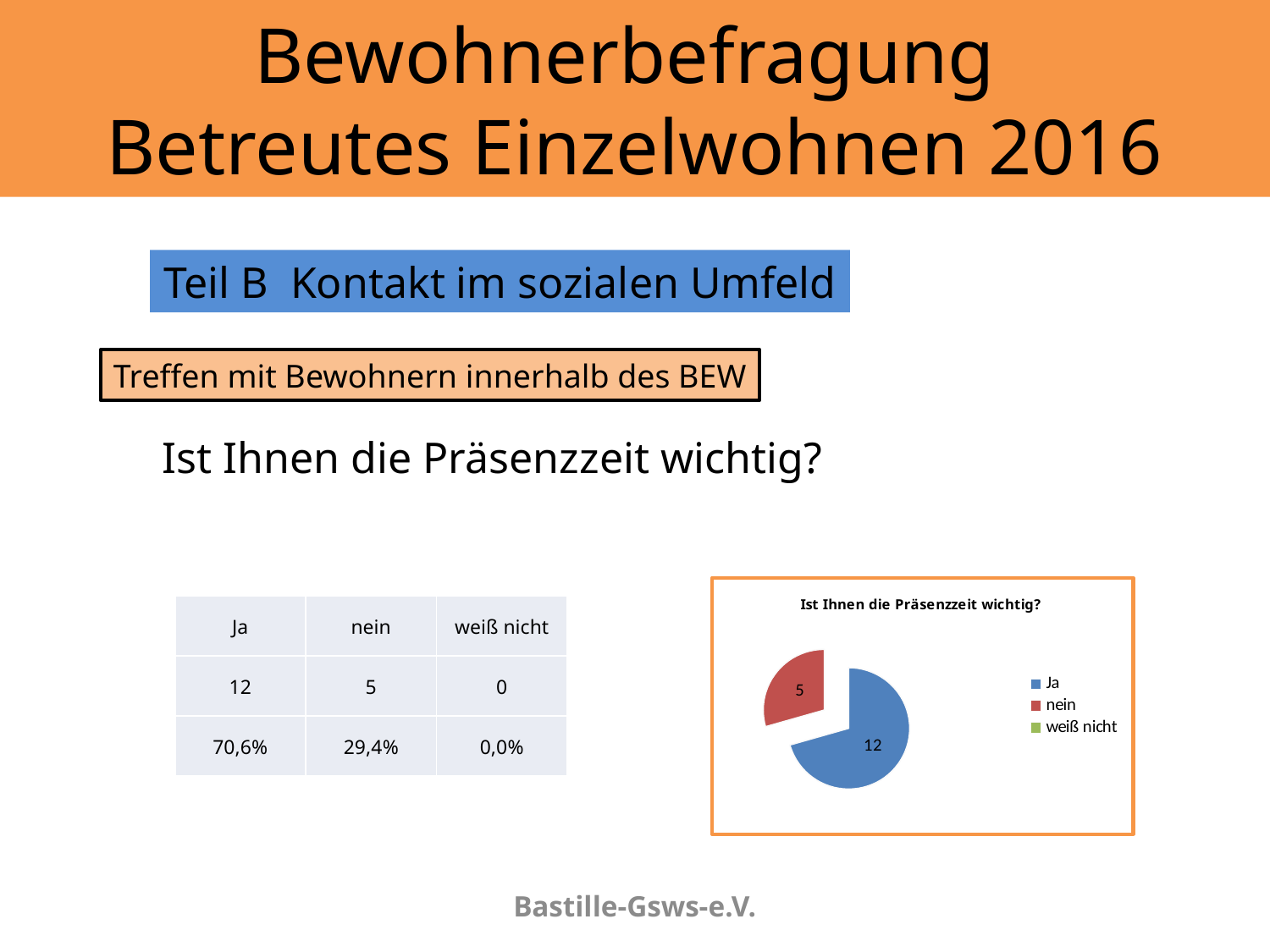
What colour is the "nein" slice in the pie chart? red What is the total of the values shown in the pie chart? 17 What is the value of the "Ja" slice in the pie chart? 12 What is the title of the pie chart? Ist Ihnen die Präsenzzeit wichtig? What share of the pie does the "Ja" slice represent, according to the table on the slide? 70,6% How many entries does the legend of the pie chart list? 3 What is the difference between the "Ja" and "nein" values in the pie chart? 7 What type of chart is shown on the slide? pie chart Which of the two visible slices is larger, "Ja" or "nein"? Ja Which category has the largest slice in the pie chart? Ja What share of the pie does the "nein" slice represent, according to the table on the slide? 29,4% What is the value of the "nein" slice in the pie chart? 5